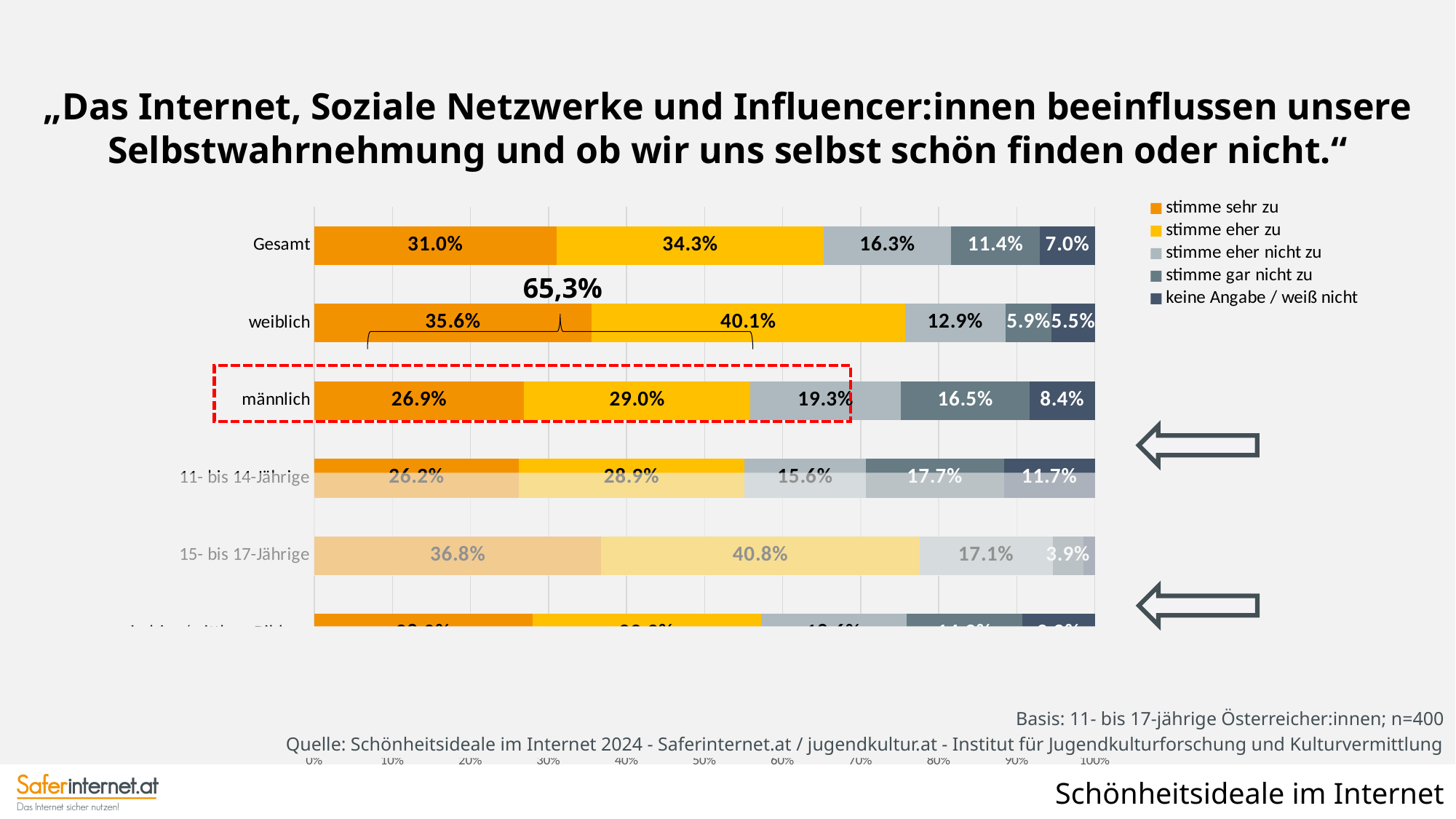
What is the "stimme gar nicht zu" value for the männlich group? 16.5% What is the "keine Angabe / weiß nicht" value for the 11- bis 14-Jährige group? 11.7% What is the "stimme eher zu" value for the weiblich group? 40.1% What is the combined share of "stimme sehr zu" and "stimme eher zu" for the Gesamt group? 65.3% How many series does the legend list? 5 What type of chart is shown on the slide? Stacked bar chart Which is larger: the "stimme eher zu" value for Gesamt or for männlich? Gesamt What is the difference in percentage points between the "stimme sehr zu" values of weiblich and männlich? 8.7 percentage points Among Gesamt, weiblich and männlich, which group has the lowest "keine Angabe / weiß nicht" share? weiblich What is the "stimme eher nicht zu" value for the 15- bis 17-Jährige group? 17.1% Among Gesamt, weiblich and männlich, which group has the highest "stimme sehr zu" share? weiblich What percentage of the Gesamt group answered "stimme sehr zu"? 31.0%